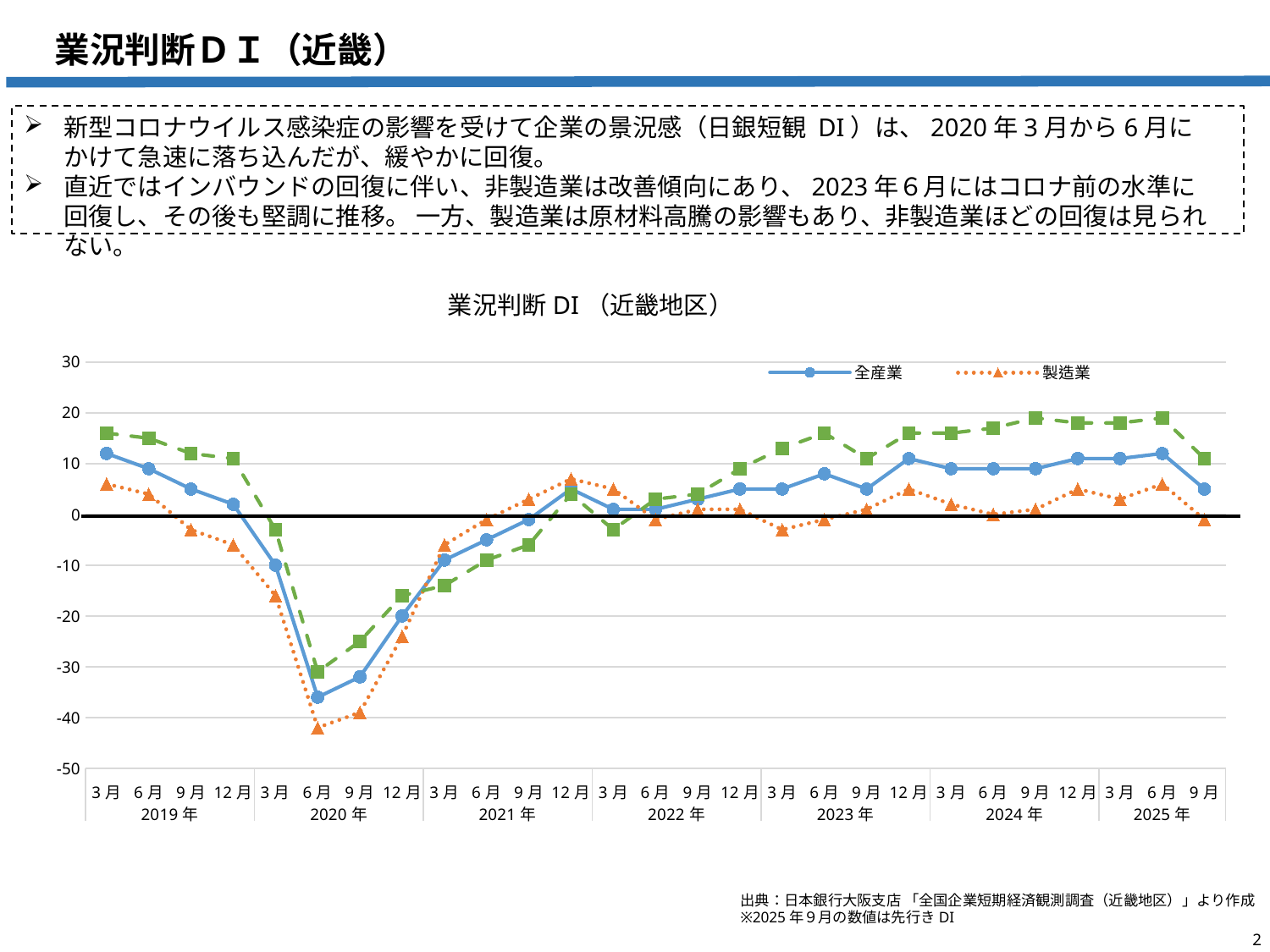
What kind of chart is shown on the slide? line chart Is the value for 全産業 in 2020年6月 greater or less than -30? less Which series are named in the chart's legend? 全産業, 製造業 How many time points are plotted along the x axis? 27 What is the title of the chart? 業況判断DI（近畿地区） How many series does the chart's legend list? 2 In 2020年6月, which series has the lower value, 全産業 or 製造業? 製造業 Does the 全産業 series rise or fall from 2019年3月 to 2020年6月? fall Is the value for 製造業 in 2020年6月 greater or less than -30? less At which time point does the 全産業 series reach its lowest value? 2020年6月 At which time point does the 製造業 series reach its lowest value? 2020年6月 Is the value for 全産業 in 2019年3月 greater or less than 10? greater